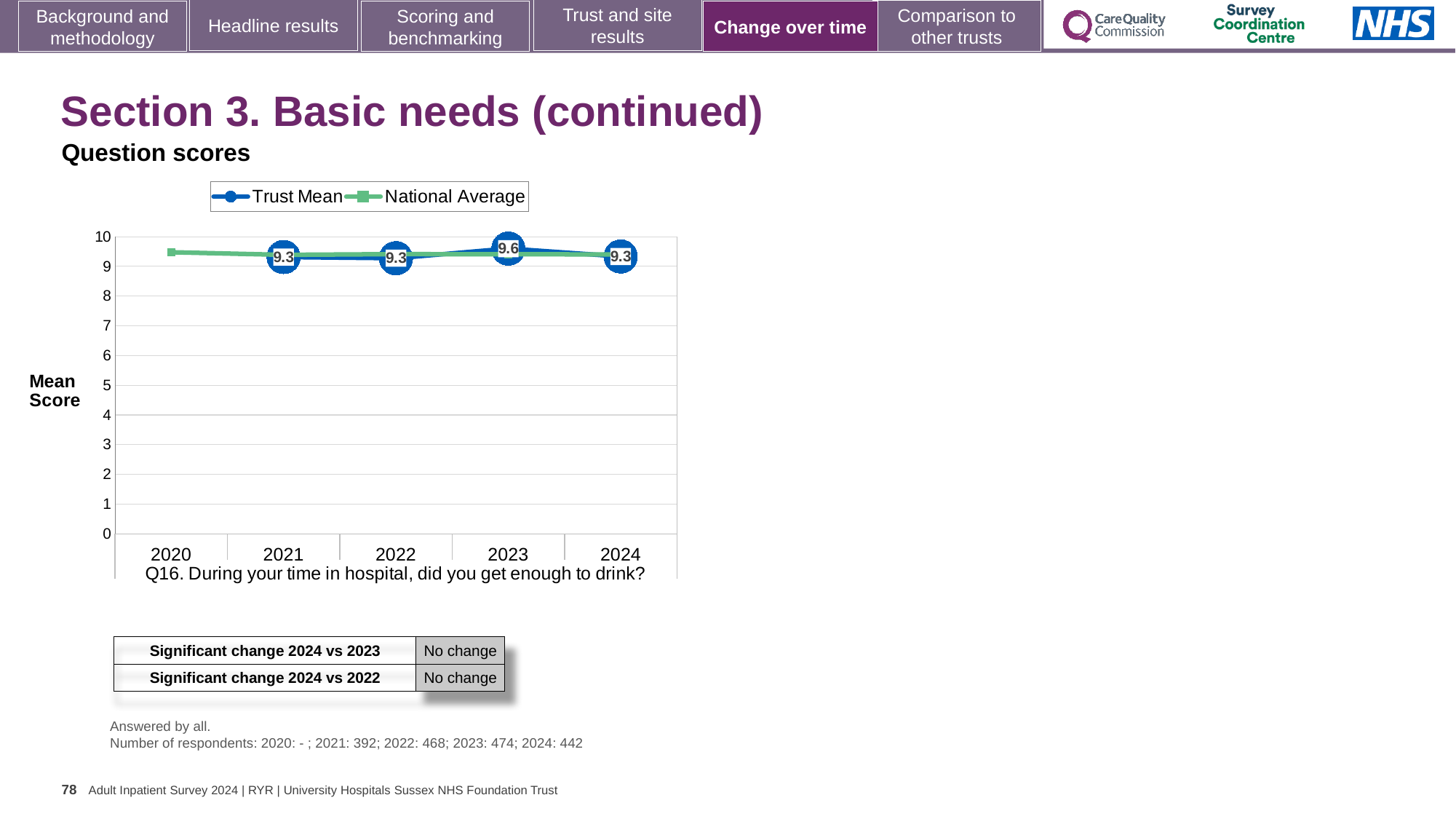
What is the Trust Mean value for 2024? 9.3 What is the Trust Mean value for 2023? 9.6 What is the Trust Mean value for 2021? 9.3 Does the Trust Mean rise or fall from 2023 to 2024? fall How many series does the legend list? 2 How many years are shown on the x axis? 5 Which year has the larger Trust Mean, 2022 or 2023? 2023 What are the two series named in the legend? Trust Mean and National Average What is the difference between the Trust Mean in 2023 and in 2024? 0.3 Is the National Average value for 2020 greater or less than 9? greater In which year is the Trust Mean highest? 2023 What kind of chart is shown on the slide? line chart